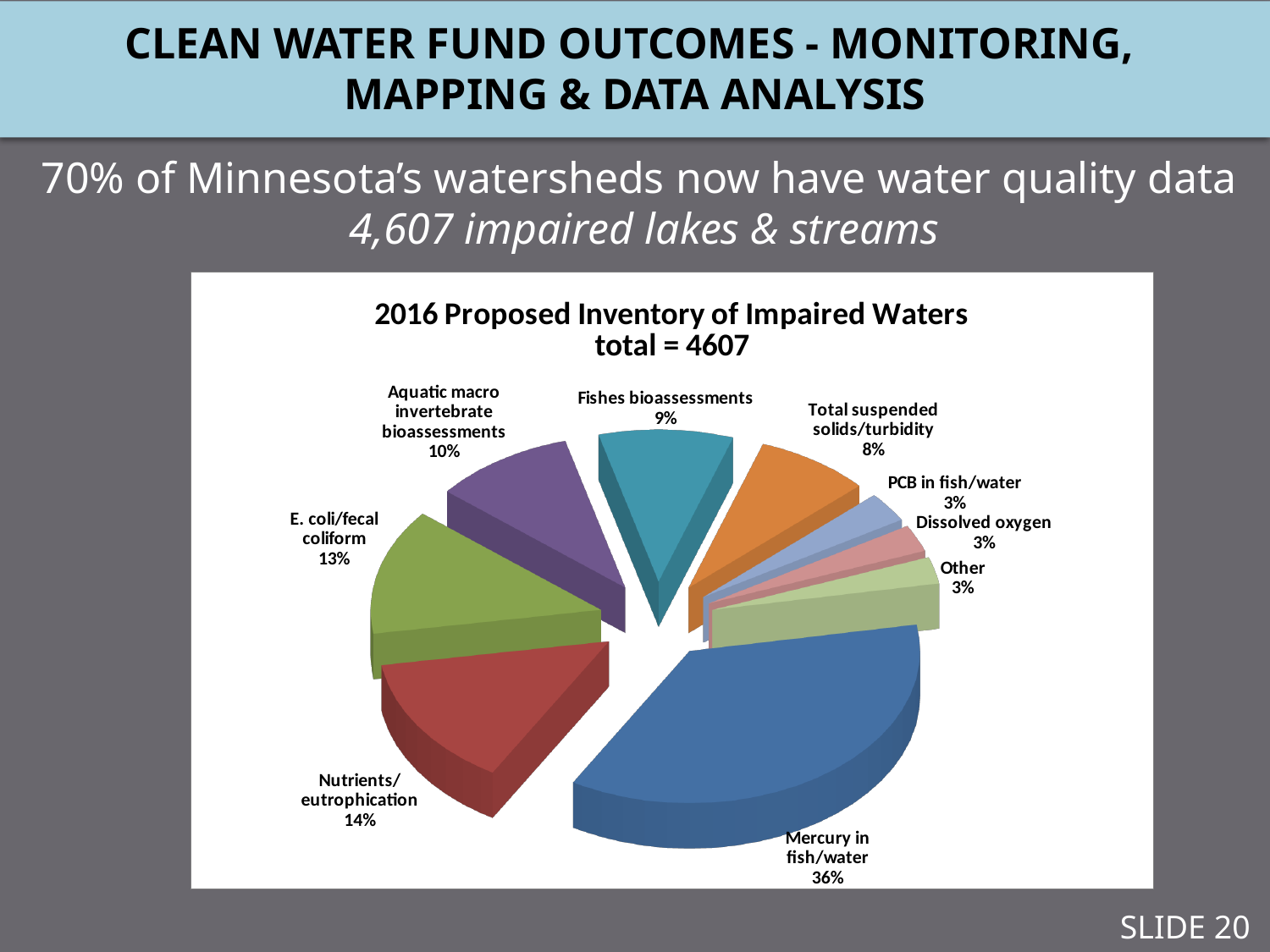
What is the title of the chart? 2016 Proposed Inventory of Impaired Waters total = 4607 What percentage is shown for E. coli/fecal coliform? 13% What share of the pie is Mercury in fish/water? 36% What is the difference in percentage points between Mercury in fish/water and Nutrients/eutrophication? 22 percentage points Which is larger, Fishes bioassessments or Total suspended solids/turbidity? Fishes bioassessments What percentage is shown for Dissolved oxygen? 3% What percentage is shown for Nutrients/eutrophication? 14% What kind of chart is shown on the slide? pie chart What percentage is shown for Aquatic macro invertebrate bioassessments? 10% Which category has the largest slice of the pie? Mercury in fish/water How many slices does the pie chart have? 9 What percentage is shown for Total suspended solids/turbidity? 8%